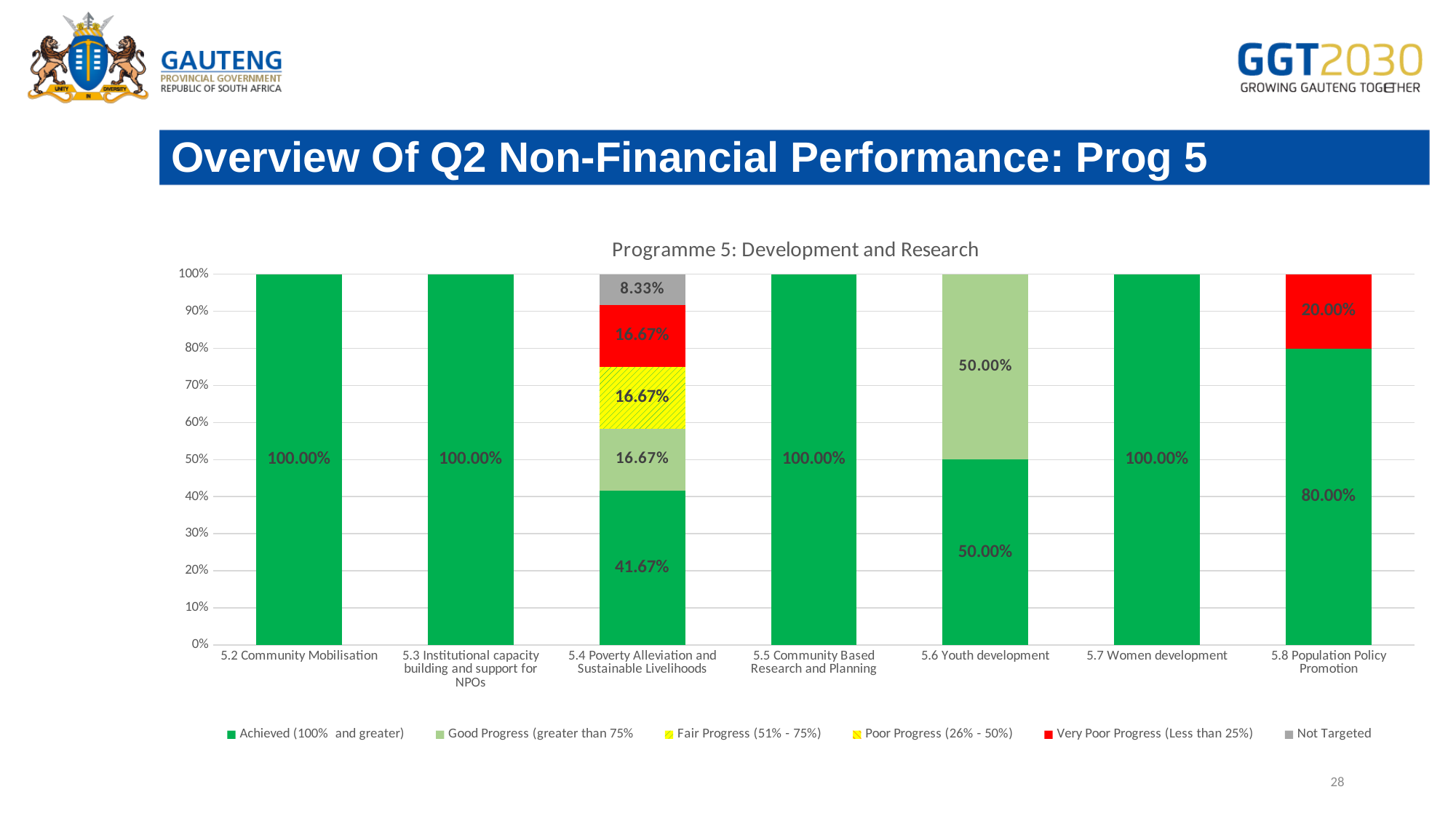
What is the title of the chart? Programme 5: Development and Research What is the Achieved (100% and greater) value for 5.7 Women development? 100.00% How many series does the chart legend list? 6 What is the difference between the Achieved values for 5.8 Population Policy Promotion and 5.6 Youth development? 30.00% How many categories (sub-programmes) are shown on the x axis of the chart? 7 What is the Good Progress (greater than 75%) value for 5.6 Youth development? 50.00% Which category has the lowest Achieved (100% and greater) value? 5.4 Poverty Alleviation and Sustainable Livelihoods Which is larger: the Achieved value for 5.8 Population Policy Promotion or for 5.4 Poverty Alleviation and Sustainable Livelihoods? 5.8 Population Policy Promotion What is the Very Poor Progress (Less than 25%) value for 5.8 Population Policy Promotion? 20.00% What is the Achieved (100% and greater) value for 5.4 Poverty Alleviation and Sustainable Livelihoods? 41.67% What is the Not Targeted value for 5.4 Poverty Alleviation and Sustainable Livelihoods? 8.33% What type of chart is shown on the slide? Stacked bar chart